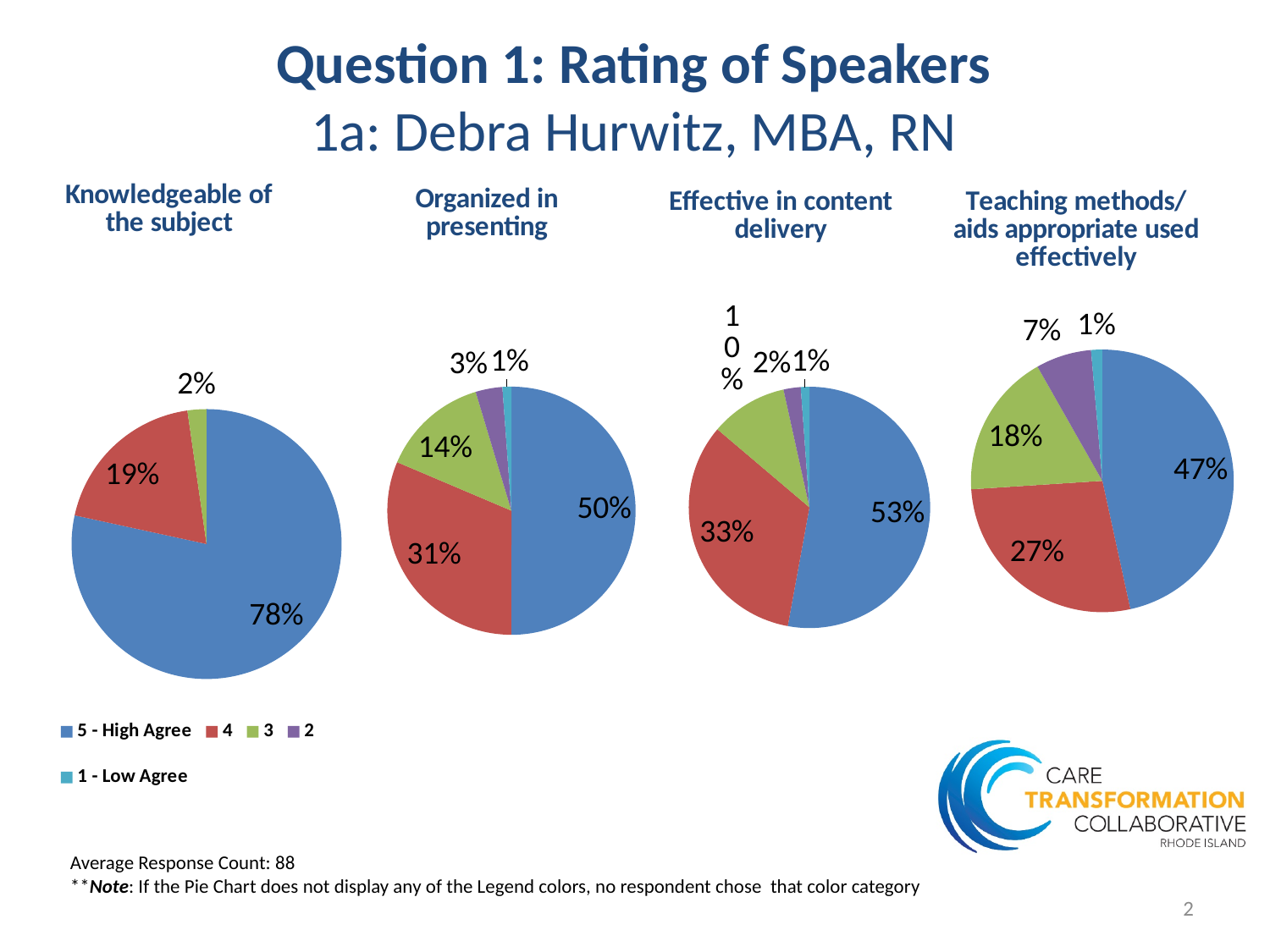
How many slices are visible in the "Knowledgeable of the subject" pie chart? 3 In the "Effective in content delivery" pie chart, what is the difference between the 5 - High Agree slice and the rating 4 slice? 20% How many rating categories does the legend list? 5 In the "Effective in content delivery" pie chart, what percentage is shown for the rating 4 slice? 33% In the "Knowledgeable of the subject" pie chart, what share of respondents chose 5 - High Agree? 78% In the "Organized in presenting" pie chart, which rating has the largest slice? 5 - High Agree In the "Teaching methods/aids appropriate used effectively" pie chart, what percentage is shown for the rating 2 slice? 7% In the "Teaching methods/aids appropriate used effectively" pie chart, which rating has the smallest slice? 1 - Low Agree In the "Knowledgeable of the subject" pie chart, what percentage is shown for the rating 4 slice? 19% Which is larger: the 5 - High Agree share in the "Knowledgeable of the subject" chart or in the "Teaching methods/aids appropriate used effectively" chart? Knowledgeable of the subject In the "Organized in presenting" pie chart, what percentage is shown for the rating 3 slice? 14% What type of chart is used to show the speaker ratings on this slide? Pie chart